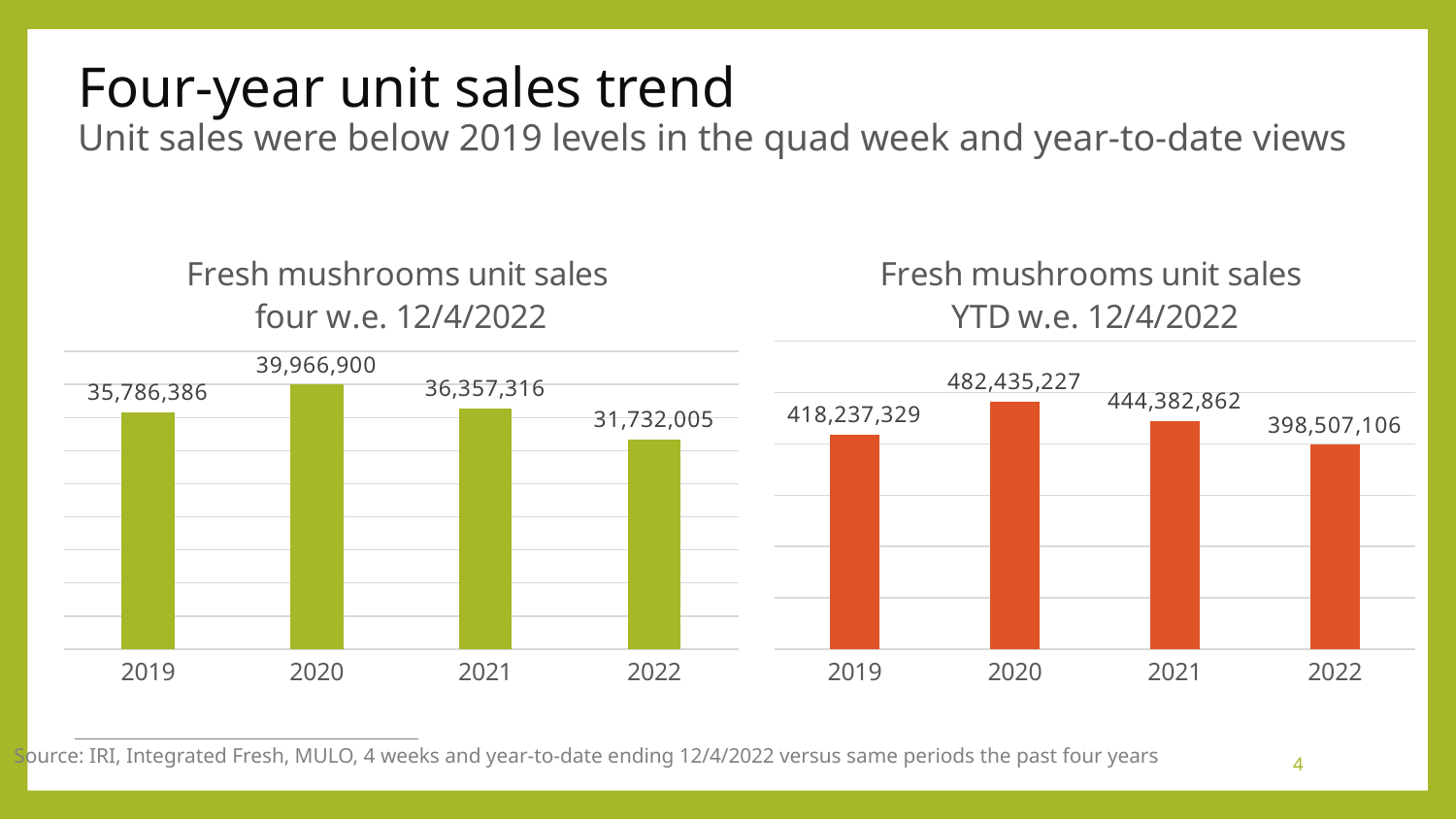
In the 'Fresh mushrooms unit sales four w.e. 12/4/2022' chart, which year has the lowest unit sales? 2022 What colour are the bars in the 'Fresh mushrooms unit sales four w.e. 12/4/2022' chart? Green In the 'Fresh mushrooms unit sales YTD w.e. 12/4/2022' chart, how much higher is the 2020 value than the 2019 value? 64,197,898 In the 'Fresh mushrooms unit sales YTD w.e. 12/4/2022' chart, do the values rise or fall from 2020 to 2022? Fall What type of chart is the 'Fresh mushrooms unit sales YTD w.e. 12/4/2022' chart? Bar chart In the 'Fresh mushrooms unit sales four w.e. 12/4/2022' chart, which is larger, the value for 2019 or the value for 2022? 2019 In the 'Fresh mushrooms unit sales four w.e. 12/4/2022' chart, what is the value for 2020? 39,966,900 In the 'Fresh mushrooms unit sales YTD w.e. 12/4/2022' chart, which year has the highest unit sales? 2020 In the 'Fresh mushrooms unit sales YTD w.e. 12/4/2022' chart, what is the value for 2022? 398,507,106 How many years are shown in the 'Fresh mushrooms unit sales four w.e. 12/4/2022' chart? 4 In the 'Fresh mushrooms unit sales YTD w.e. 12/4/2022' chart, which is larger, the value for 2019 or the value for 2021? 2021 In the 'Fresh mushrooms unit sales four w.e. 12/4/2022' chart, what is the difference between the 2020 and 2022 values? 8,234,895